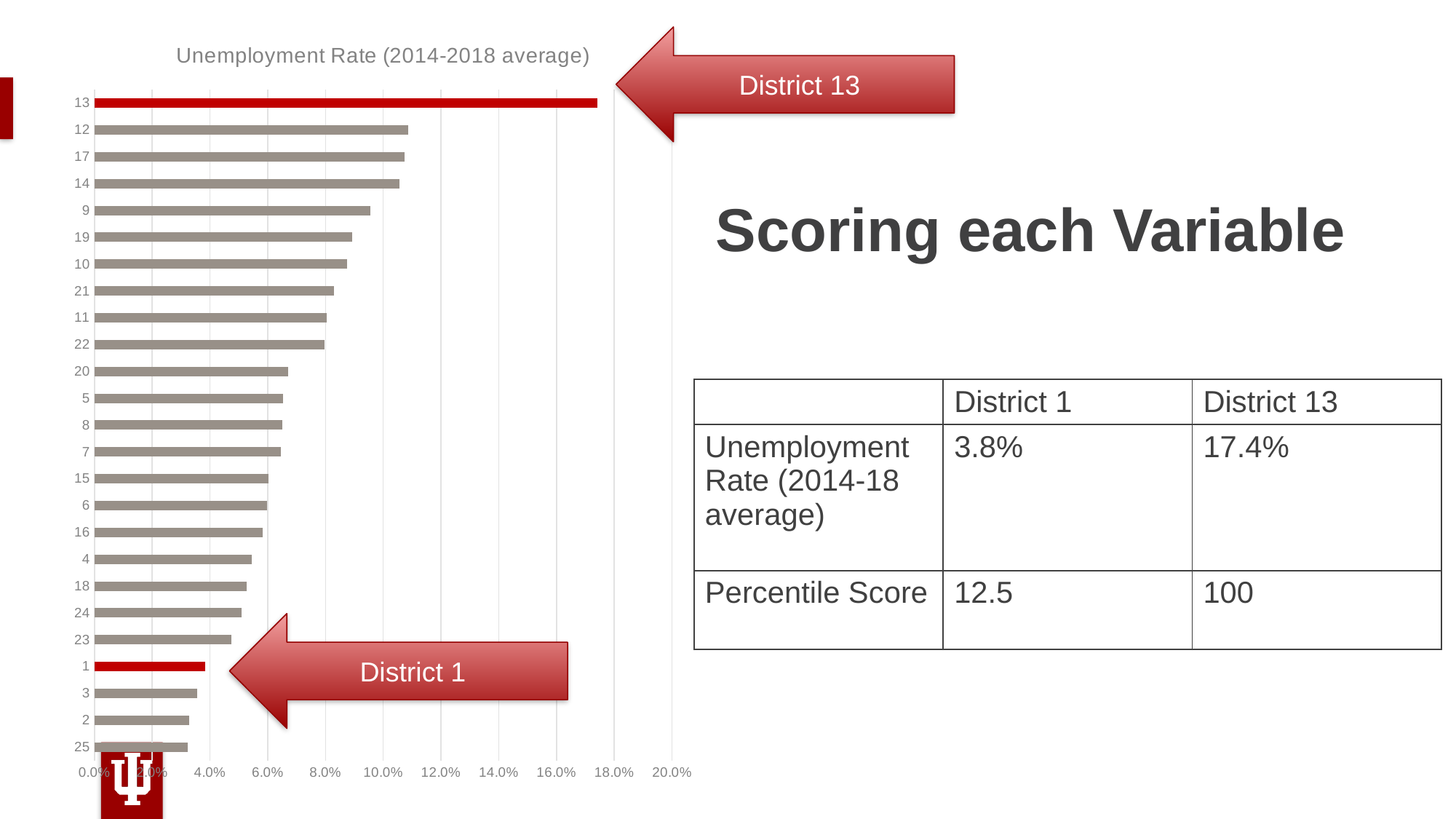
What is the unemployment rate for District 1? 3.8% What is the title of the chart? Unemployment Rate (2014-2018 average) What is the difference between the unemployment rates of District 13 and District 1? 13.6% Is the unemployment rate for district 25 greater or less than 4.0%? less Is the unemployment rate for district 4 greater or less than 6.0%? less Which district has a higher unemployment rate, district 12 or district 23? 12 Which two districts are highlighted in red in the chart? 13 and 1 What is the unemployment rate for District 13? 17.4% How many districts are plotted in the chart? 25 Which district has the highest unemployment rate in the chart? 13 What kind of chart is shown on the slide? bar chart Is the unemployment rate for district 12 greater or less than 10.0%? greater